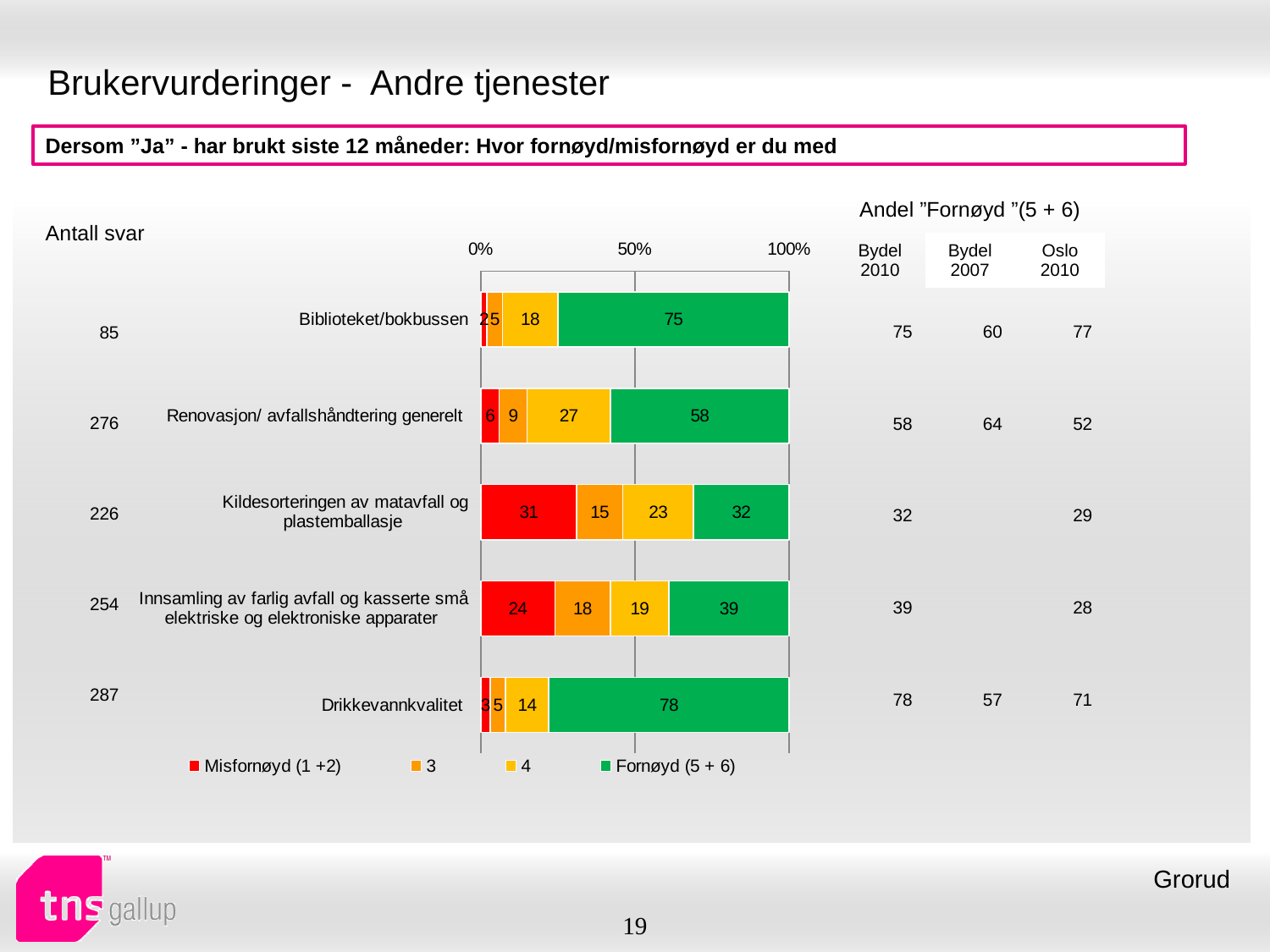
Which colour represents the Fornøyd (5 + 6) series in the chart? green How many categories (services) are plotted in the chart? 5 What is the value of series 4 for Renovasjon/ avfallshåndtering generelt? 27 What kind of chart is shown on the slide? stacked bar chart Which is larger: the Misfornøyd (1 +2) value for Kildesorteringen av matavfall og plastemballasje or for Innsamling av farlig avfall og kasserte små elektriske og elektroniske apparater? Kildesorteringen av matavfall og plastemballasje Which category has the highest Fornøyd (5 + 6) value? Drikkevannkvalitet What is the difference between the Fornøyd (5 + 6) values for Biblioteket/bokbussen and Renovasjon/ avfallshåndtering generelt? 17 How many series does the chart legend list? 4 What is the value of series 3 for Innsamling av farlig avfall og kasserte små elektriske og elektroniske apparater? 18 What is the Fornøyd (5 + 6) value for Drikkevannkvalitet? 78 Which category has the lowest Fornøyd (5 + 6) value? Kildesorteringen av matavfall og plastemballasje What is the Misfornøyd (1 +2) value for Kildesorteringen av matavfall og plastemballasje? 31